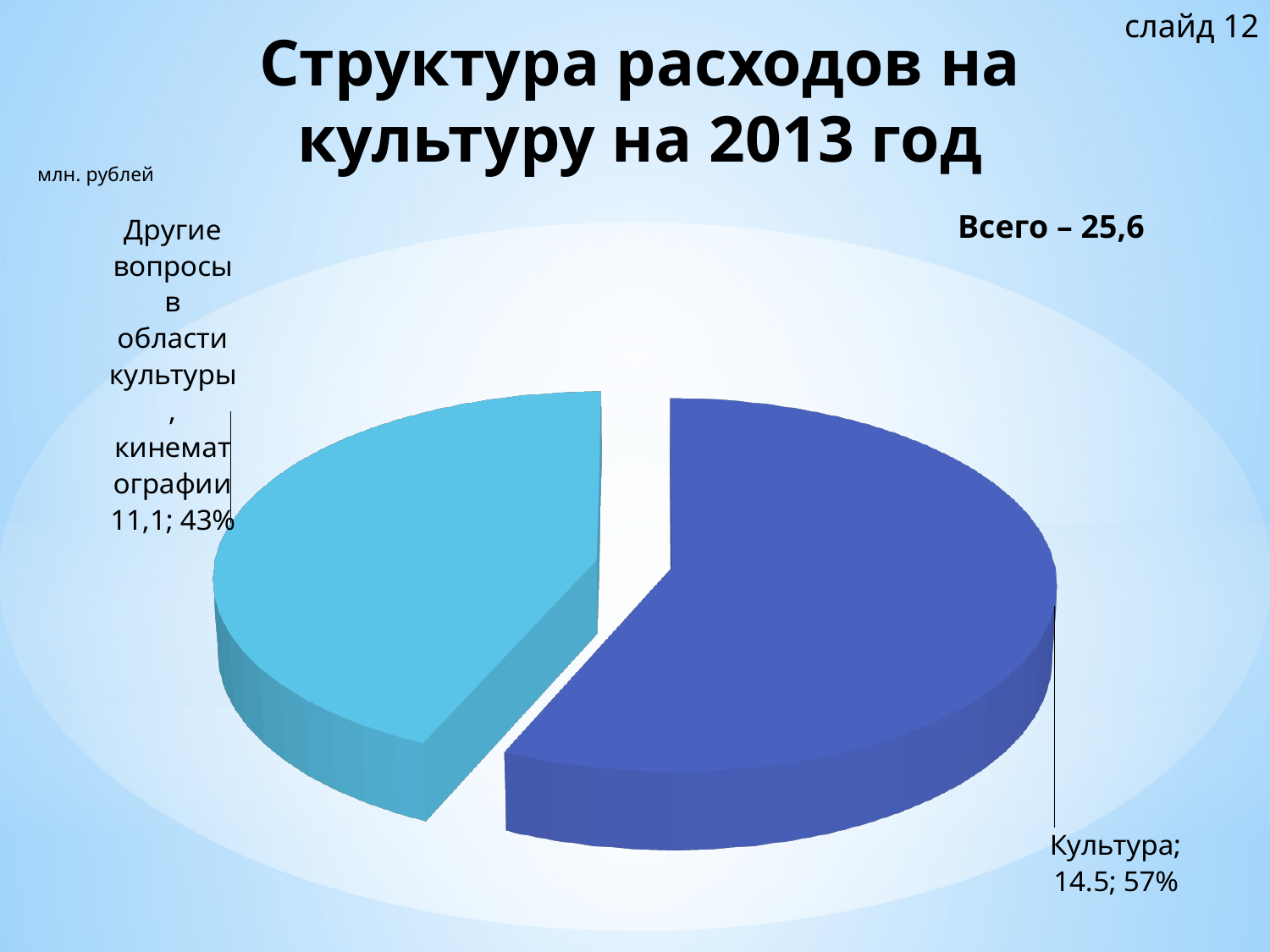
What is the value for Культура? 14.5 What is the value for Другие вопросы в области культуры, кинематографии? 11,1 How many slices does the pie chart have? 2 Which slice is the largest? Культура What share of the pie does Другие вопросы в области культуры, кинематографии take? 43% In what units are the values given? млн. рублей Which slice is the smallest? Другие вопросы в области культуры, кинематографии What is the total of all slices as stated on the slide? 25,6 What share of the pie does Культура take? 57% What is the title of the chart? Структура расходов на культуру на 2013 год What kind of chart is shown on the slide? pie chart Which is larger: Культура or Другие вопросы в области культуры, кинематографии? Культура